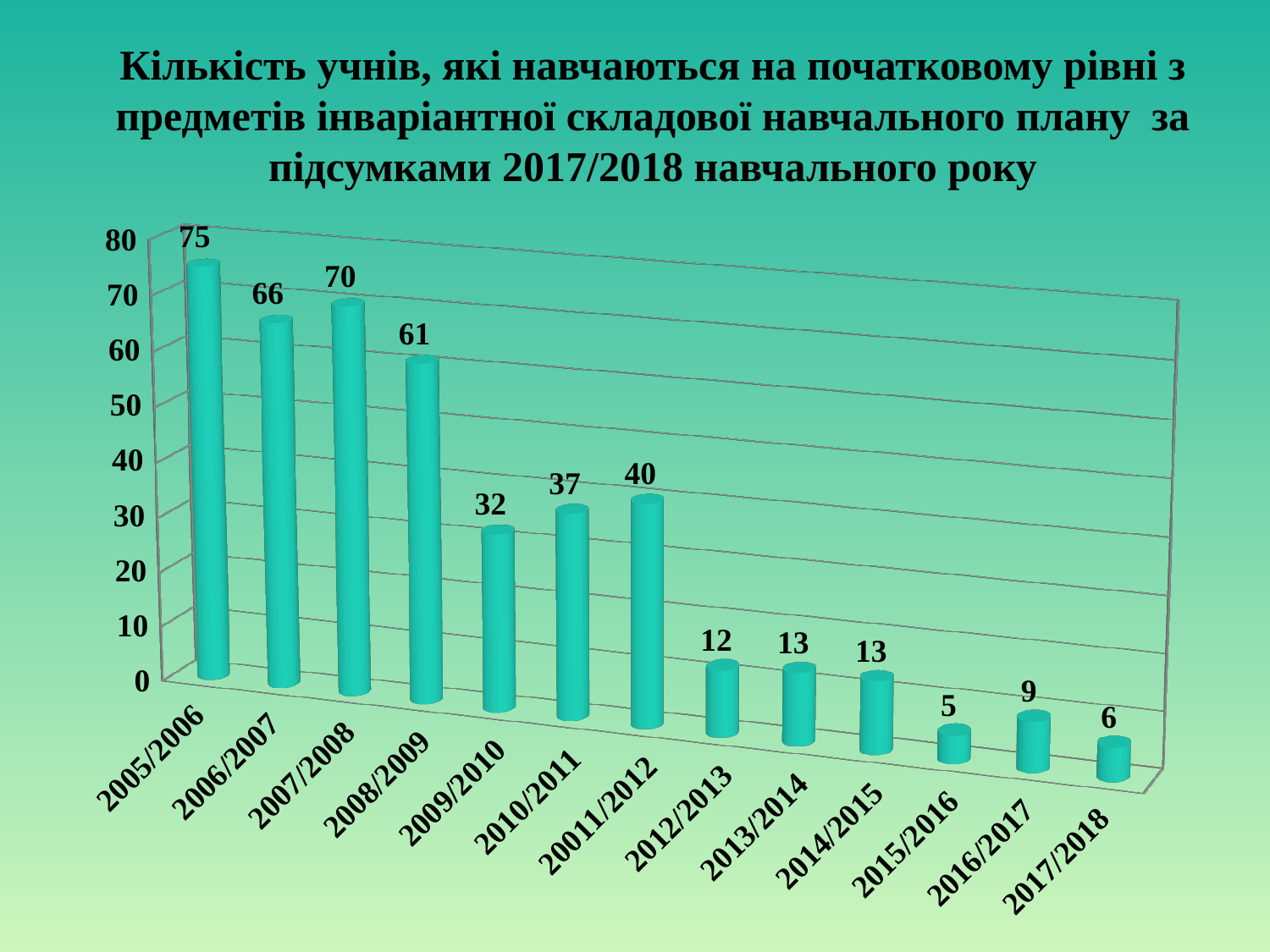
What is the value for 2008/2009? 61 Which school year has the highest value? 2005/2006 Do the values generally rise or fall from 2005/2006 to 2017/2018? Fall What kind of chart is shown on the slide? Bar chart Which school year has the lowest value? 2015/2016 What is the value for 2017/2018? 6 What is the value for 2015/2016? 5 Which is larger, the value for 2007/2008 or the value for 2008/2009? 2007/2008 What is the difference between the values for 2009/2010 and 2010/2011? 5 What is the value for 2005/2006? 75 How many school years are shown on the x axis? 13 What is the difference between the values for 2005/2006 and 2006/2007? 9